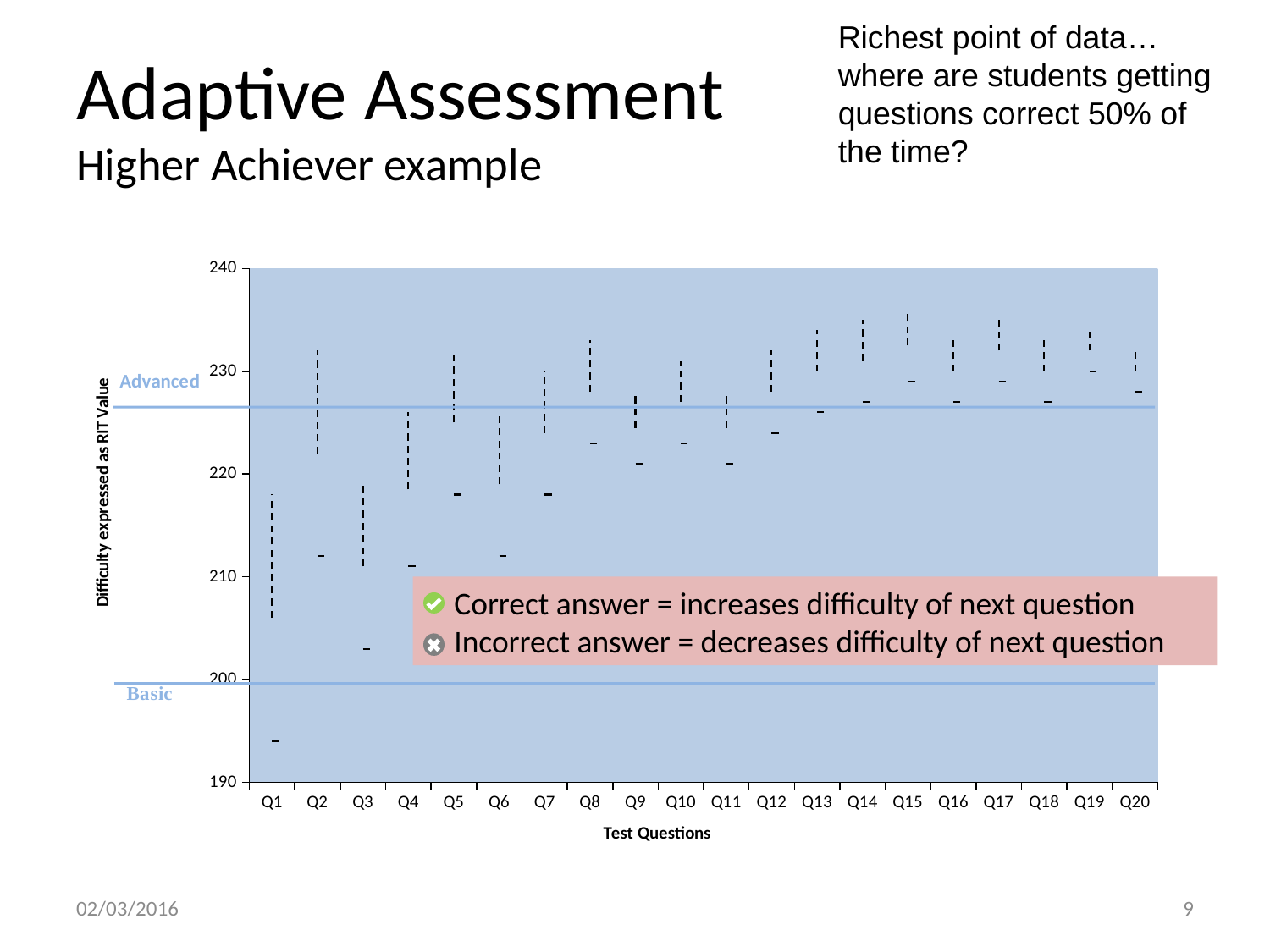
Is the lowest plotted value for Q20 greater or less than 220? greater What is the title of the chart's y axis? Difficulty expressed as RIT Value Overall, do the plotted difficulty values rise or fall from Q1 to Q20? rise Is the lowest plotted value for Q1 larger or smaller than the lowest plotted value for Q20? smaller Which test question has the lowest plotted difficulty value on the chart? Q1 What is the title of the chart's x axis? Test Questions Is the highest plotted value for Q15 greater or less than 230? greater Is the lowest plotted value for Q1 greater or less than 200? less How many test questions are shown along the x axis of the chart? 20